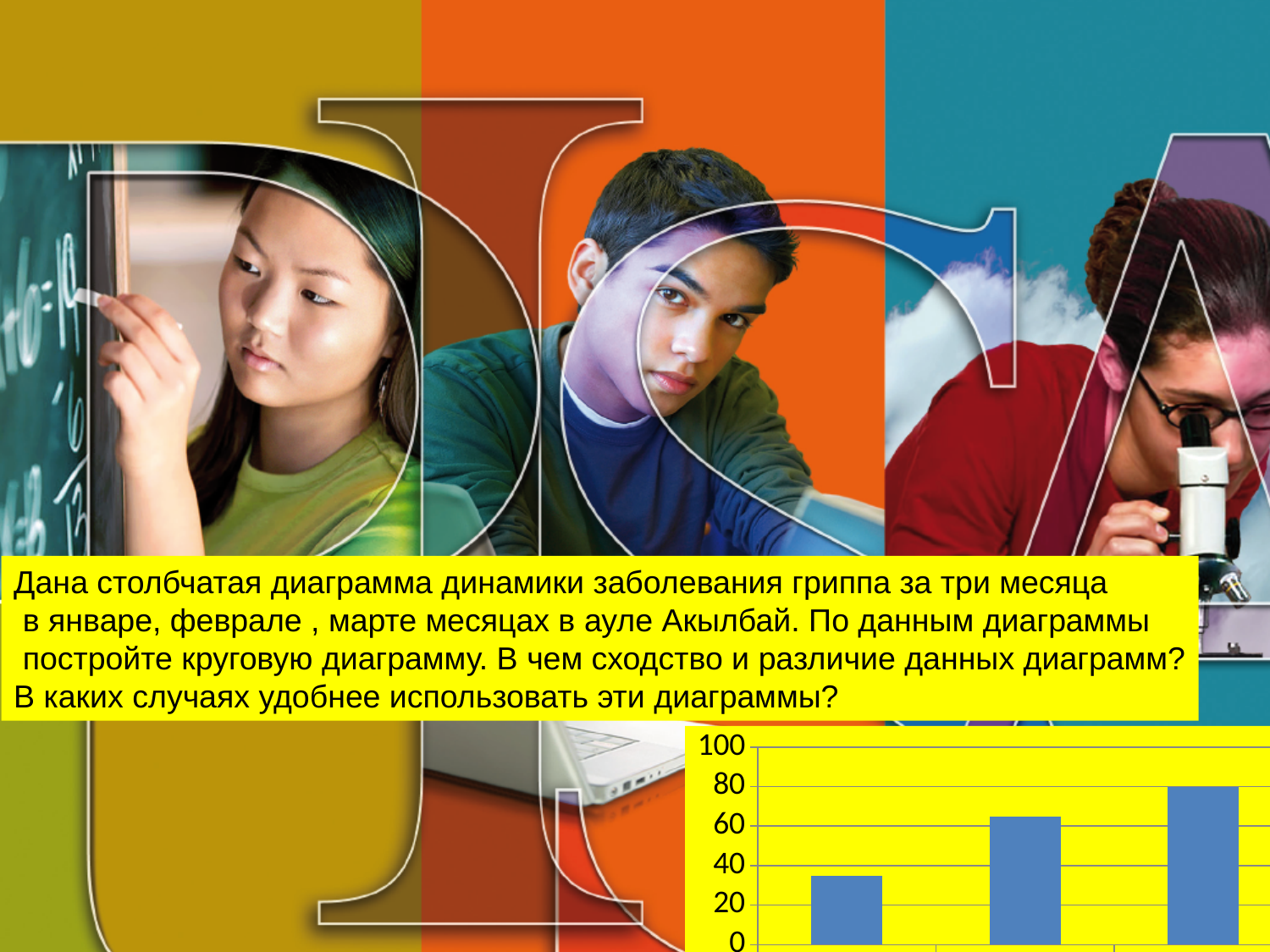
Is the value of the middle bar greater or less than 60? greater Which bar is the tallest in the chart: the first, second or third from the left? third Is the value of the middle bar greater or less than 80? less Do the bar values rise or fall from left to right? rise What is the highest value shown on the vertical axis of the chart? 100 Which bar is the shortest in the chart: the first, second or third from the left? first What kind of chart is shown at the bottom right of the slide? bar chart Which is larger, the middle bar or the rightmost bar? the rightmost bar Is the value of the leftmost bar greater or less than 20? greater How many bars does the chart show? 3